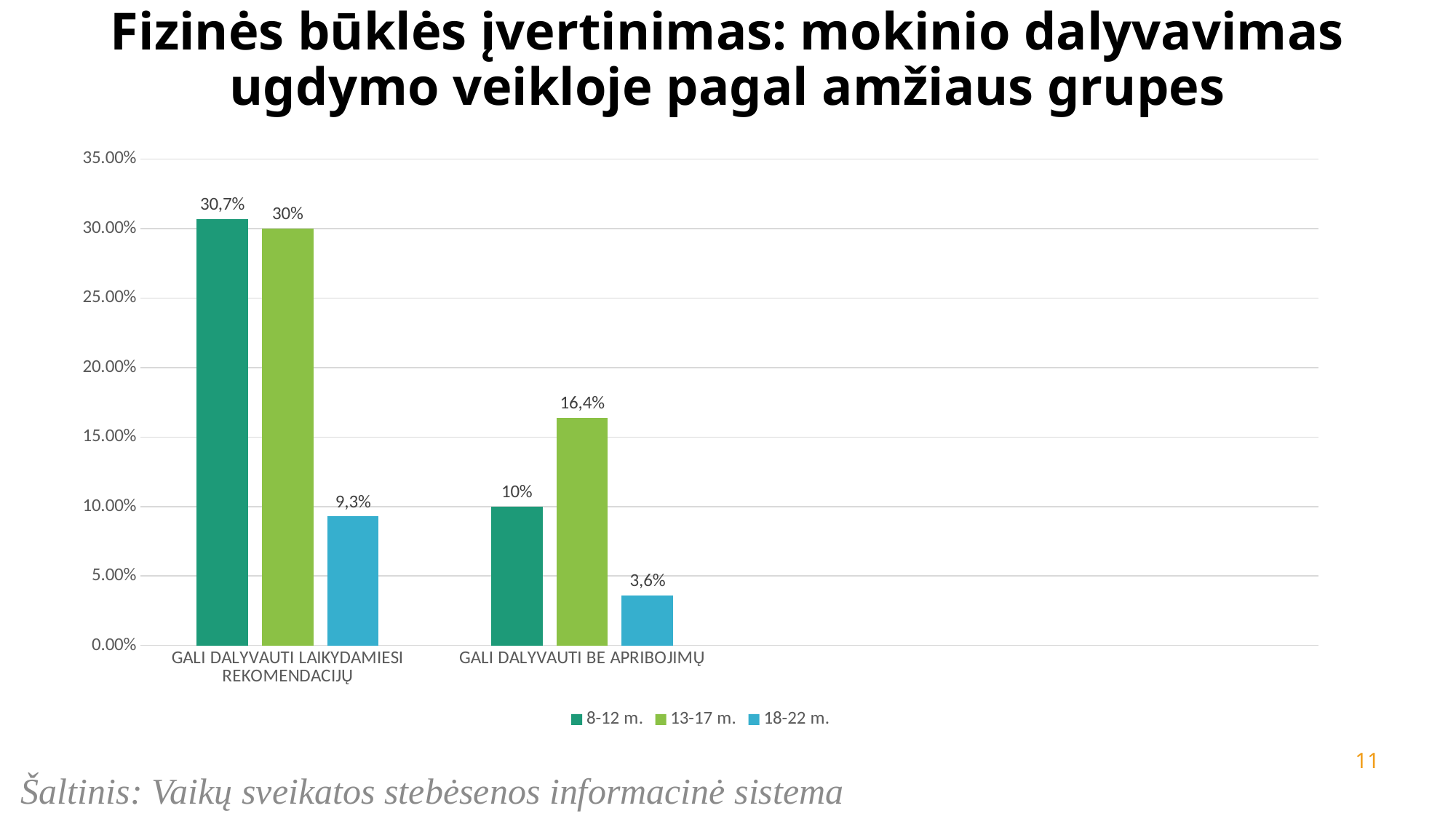
What is the value for the 8-12 m. series in the 'Gali dalyvauti laikydamiesi rekomendacijų' category? 30,7% Which age group has the highest value in the 'Gali dalyvauti be apribojimų' category? 13-17 m. What is the value for the 13-17 m. series in the 'Gali dalyvauti be apribojimų' category? 16,4% Which is larger: the 8-12 m. value for 'Gali dalyvauti laikydamiesi rekomendacijų' or the 8-12 m. value for 'Gali dalyvauti be apribojimų'? Gali dalyvauti laikydamiesi rekomendacijų What is the value for the 18-22 m. series in the 'Gali dalyvauti laikydamiesi rekomendacijų' category? 9,3% What is the value for the 18-22 m. series in the 'Gali dalyvauti be apribojimų' category? 3,6% What kind of chart is shown on the slide? Bar chart What is the difference between the 18-22 m. values in the two categories? 5,7 percentage points How many categories are shown on the x axis? 2 What is the difference between the 13-17 m. and 8-12 m. values in the 'Gali dalyvauti be apribojimų' category? 6,4 percentage points Which age group has the lowest value in the 'Gali dalyvauti laikydamiesi rekomendacijų' category? 18-22 m. How many series does the legend list? 3